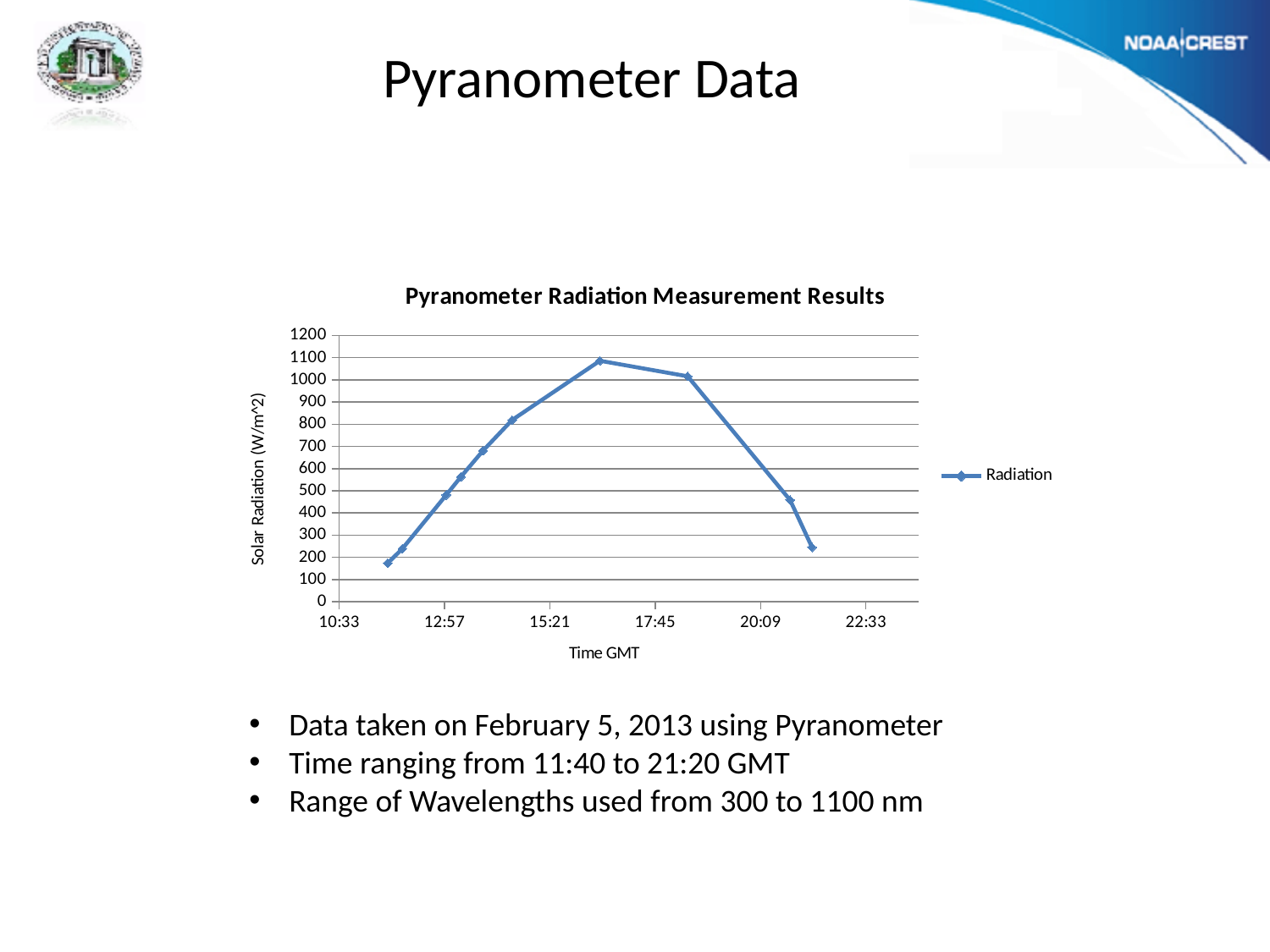
How does the Radiation value change along the time axis? It rises to a peak and then falls Is the first plotted Radiation value (around 11:40) greater or less than 200? less What is the title of the chart? Pyranometer Radiation Measurement Results How many data points are plotted on the Radiation line? 10 What is the label of the y axis? Solar Radiation (W/m^2) How many series does the chart legend list? 1 What kind of chart is shown on the slide? Line chart Which is larger, the first plotted Radiation value or the last plotted Radiation value? The last plotted value What is the name of the series shown in the legend? Radiation Is the last plotted Radiation value (around 21:20) greater or less than 300? less Is the Radiation value plotted just after 20:09 greater or less than 500? less